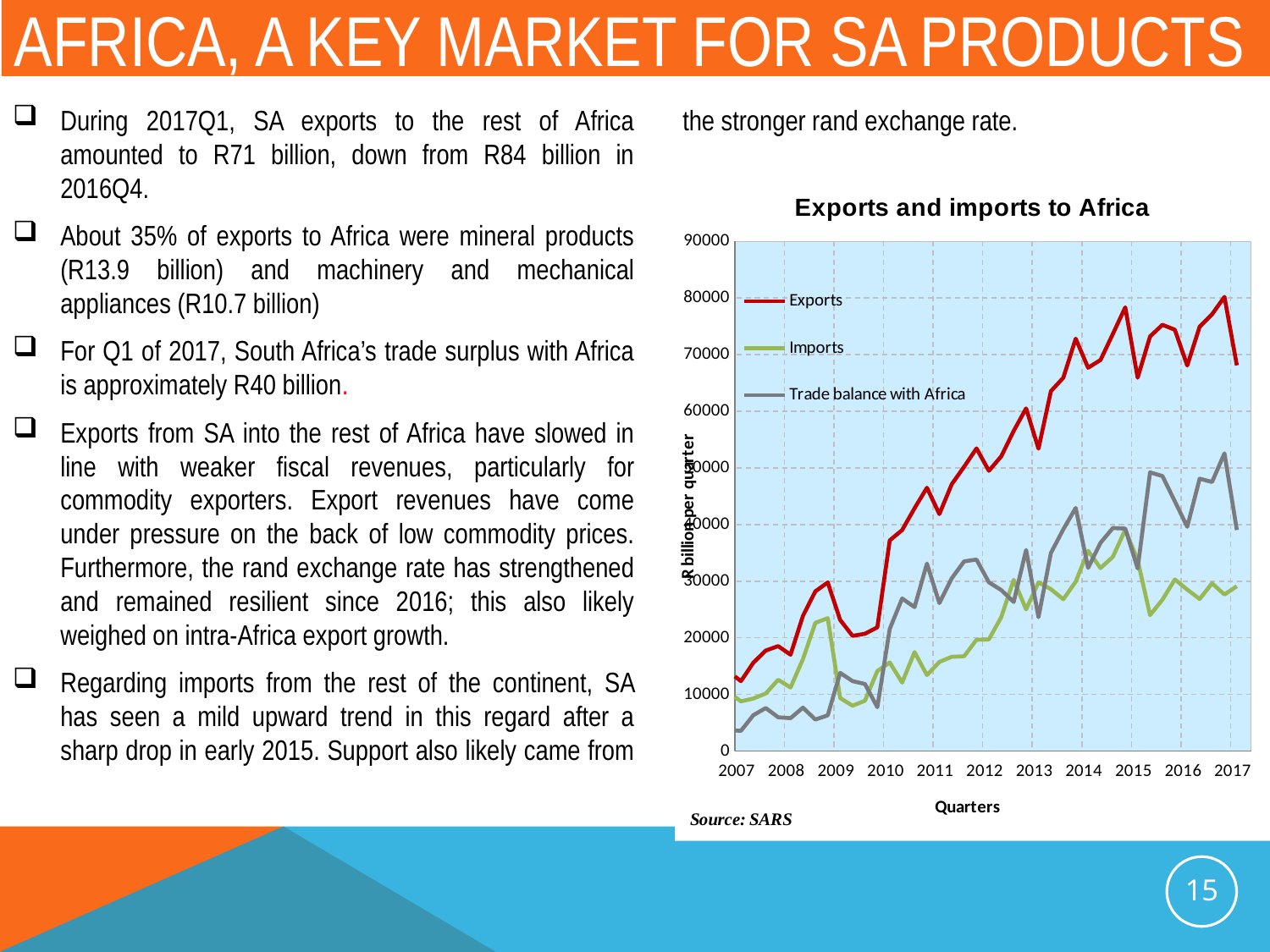
What kind of chart is shown on the slide? Line chart What is the title of the chart? Exports and imports to Africa Is the value for Imports at the end of the series in 2017 greater or less than 20000? greater Is the value for Trade balance with Africa at the start of 2007 greater or less than 10000? less Do the values for Exports generally rise or fall from 2007 to 2017? rise How many series does the chart legend list? 3 At the end of the series in 2017, which is larger: Imports or Trade balance with Africa? Trade balance with Africa Which series has the highest value at the end of the series in 2017? Exports Is the value for Exports at the start of 2007 greater or less than 20000? less What is the label on the vertical axis of the chart? R billion per quarter Which series is plotted with the red line? Exports